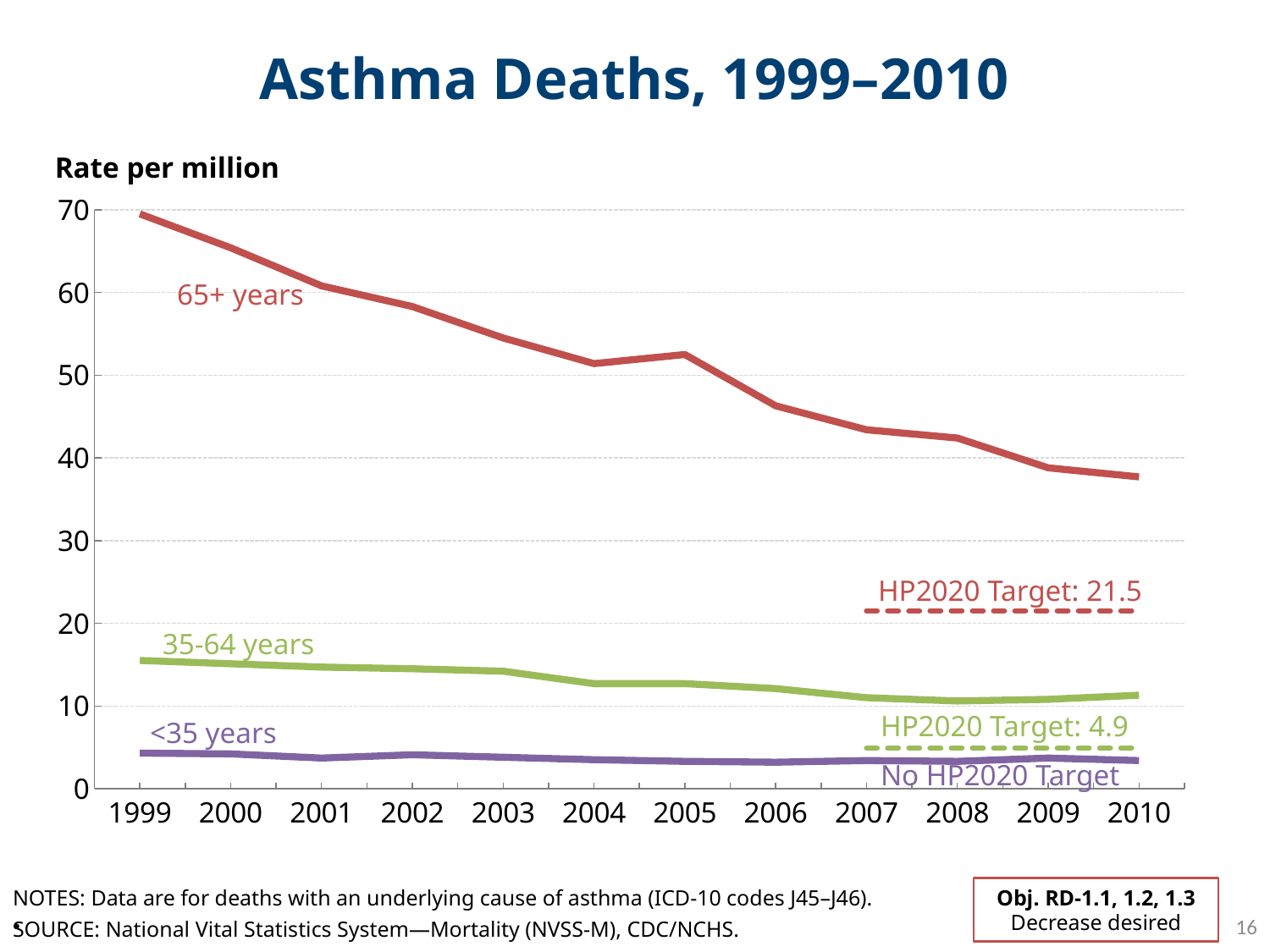
Does the asthma death rate for the 65+ years group rise or fall from 1999 to 2010? fall Which age group has the highest asthma death rate in 1999? 65+ years Is the value for the 65+ years group in 2010 greater or less than 40? less What is the title of the chart? Asthma Deaths, 1999–2010 What kind of chart is shown on the slide? line chart Is the value for the 65+ years group in 1999 greater or less than 60? greater What is the HP2020 Target shown for the 65+ years group? 21.5 Which age group has the lowest asthma death rate in 2010? <35 years How many age-group lines are plotted on the chart? 3 Is the value for the 35-64 years group in 2010 greater or less than 10? greater What is the HP2020 Target shown for the 35-64 years group? 4.9 How many years are plotted along the x axis? 12